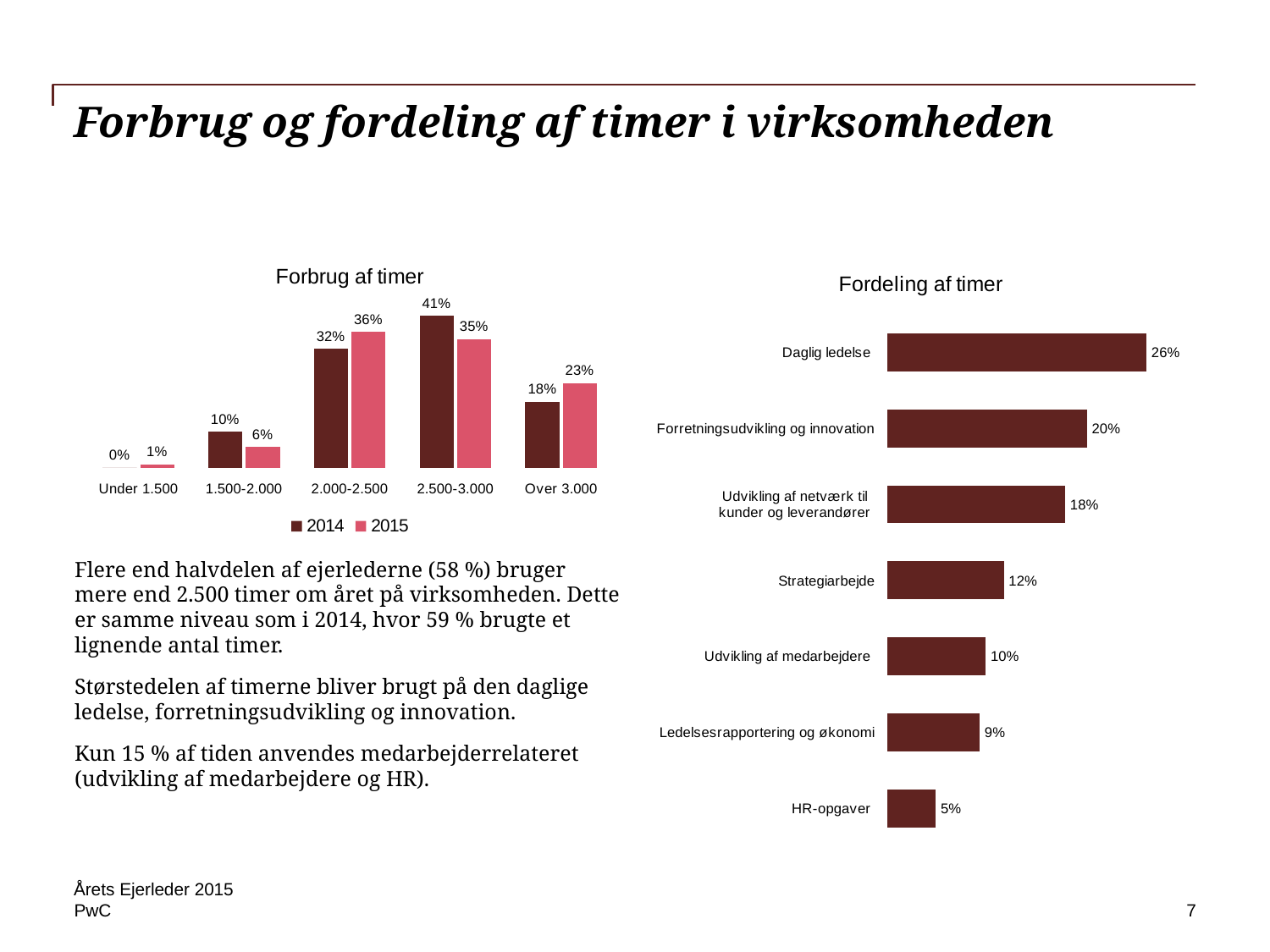
In the 'Forbrug af timer' chart, what is the difference between the 2014 and 2015 values for 2.500-3.000? 6% In the 'Forbrug af timer' chart, what is the 2014 value for Over 3.000? 18% In the 'Forbrug af timer' chart, which category has the lowest 2015 value? Under 1.500 How many categories are shown in the 'Fordeling af timer' chart? 7 How many series does the legend of the 'Forbrug af timer' chart list? 2 In the 'Fordeling af timer' chart, which category has the highest value? Daglig ledelse In the 'Fordeling af timer' chart, which category has the lowest value? HR-opgaver In the 'Fordeling af timer' chart, what is the value for Strategiarbejde? 12% In the 'Forbrug af timer' chart, is the 2014 or 2015 value larger for 1.500-2.000? 2014 In the 'Forbrug af timer' chart, which category has the highest 2014 value? 2.500-3.000 In the 'Forbrug af timer' chart, what is the 2015 value for 2.000-2.500? 36% What kind of chart is the 'Fordeling af timer' chart? Bar chart